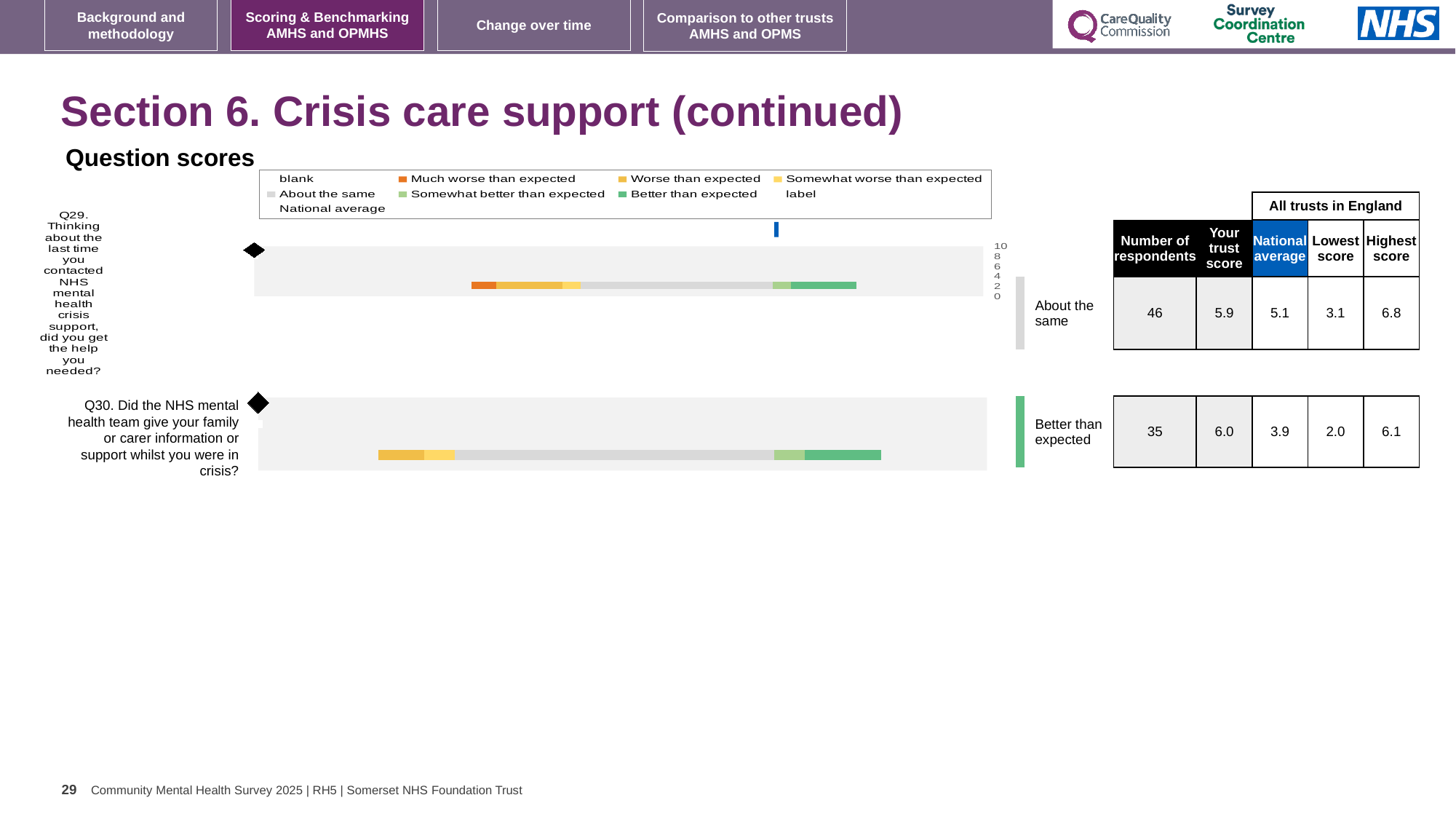
Which question has the higher 'Your trust score' in the table beside the chart, Q29 or Q30? Q30 What is the national average score for Q30 in the table beside the chart? 3.9 Which benchmark category is shown for Q30 next to its bar? Better than expected In the legend of the question scores chart, which colour represents 'Better than expected'? green What is the 'Your trust score' value for Q29 in the table beside the chart? 5.9 What kind of chart is used to show the question scores for Q29 and Q30? bar chart How many questions are plotted in the question scores chart? 2 By how much does the trust score for Q30 exceed the national average for Q30? 2.1 What is the lowest score among all trusts in England for Q30? 2.0 What is the difference between the highest and lowest scores for Q29 among all trusts in England? 3.7 What is the highest score among all trusts in England for Q29? 6.8 In the table next to the chart, how many respondents are listed for Q29? 46